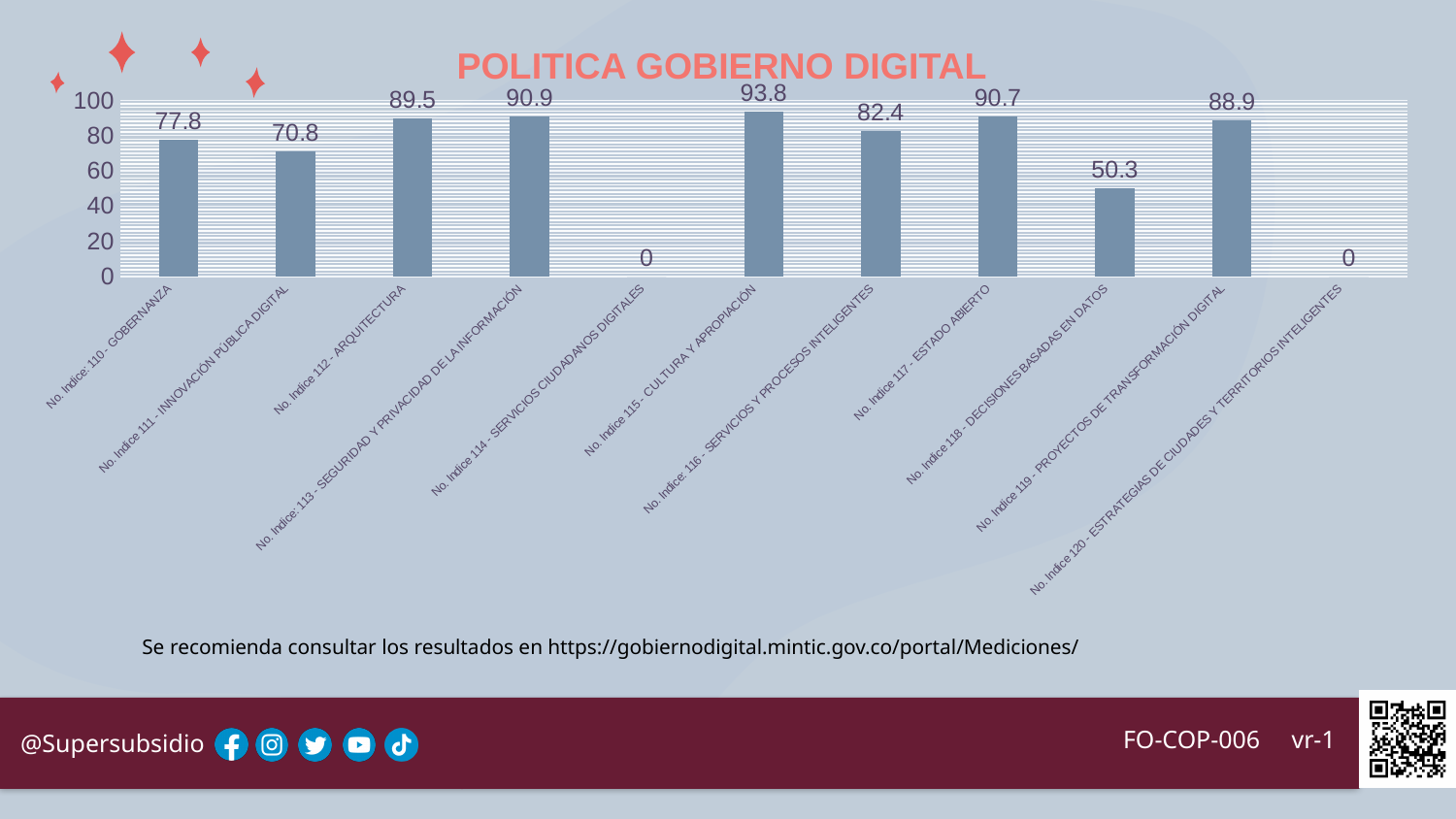
Is the value for No. Indice: 119 - PROYECTOS DE TRANSFORMACIÓN DIGITAL greater or less than 80? greater What is the value for No. Indice: 114 - SERVICIOS CIUDADANOS DIGITALES? 0 What is the difference between the values for No. Indice: 112 - ARQUITECTURA and No. Indice: 111 - INNOVACIÓN PUBLICA DIGITAL? 18.7 What is the value for No. Indice: 110 - GOBERNANZA? 77.8 Which is larger, the value for No. Indice: 113 - SEGURIDAD Y PRIVACIDAD DE LA INFORMACIÓN or the value for No. Indice: 116 - SERVICIOS Y PROCESOS INTELIGENTES? No. Indice: 113 - SEGURIDAD Y PRIVACIDAD DE LA INFORMACIÓN What is the value for No. Indice: 117 - ESTADO ABIERTO? 90.7 What is the title of the chart? POLITICA GOBIERNO DIGITAL How many categories have a value of 0? 2 Which category has the highest value? No. Indice: 115 - CULTURA Y APROPIACIÓN What kind of chart is shown on the slide? bar chart How many categories are shown on the x axis? 11 What is the value for No. Indice: 118 - DECISIONES BASADAS EN DATOS? 50.3